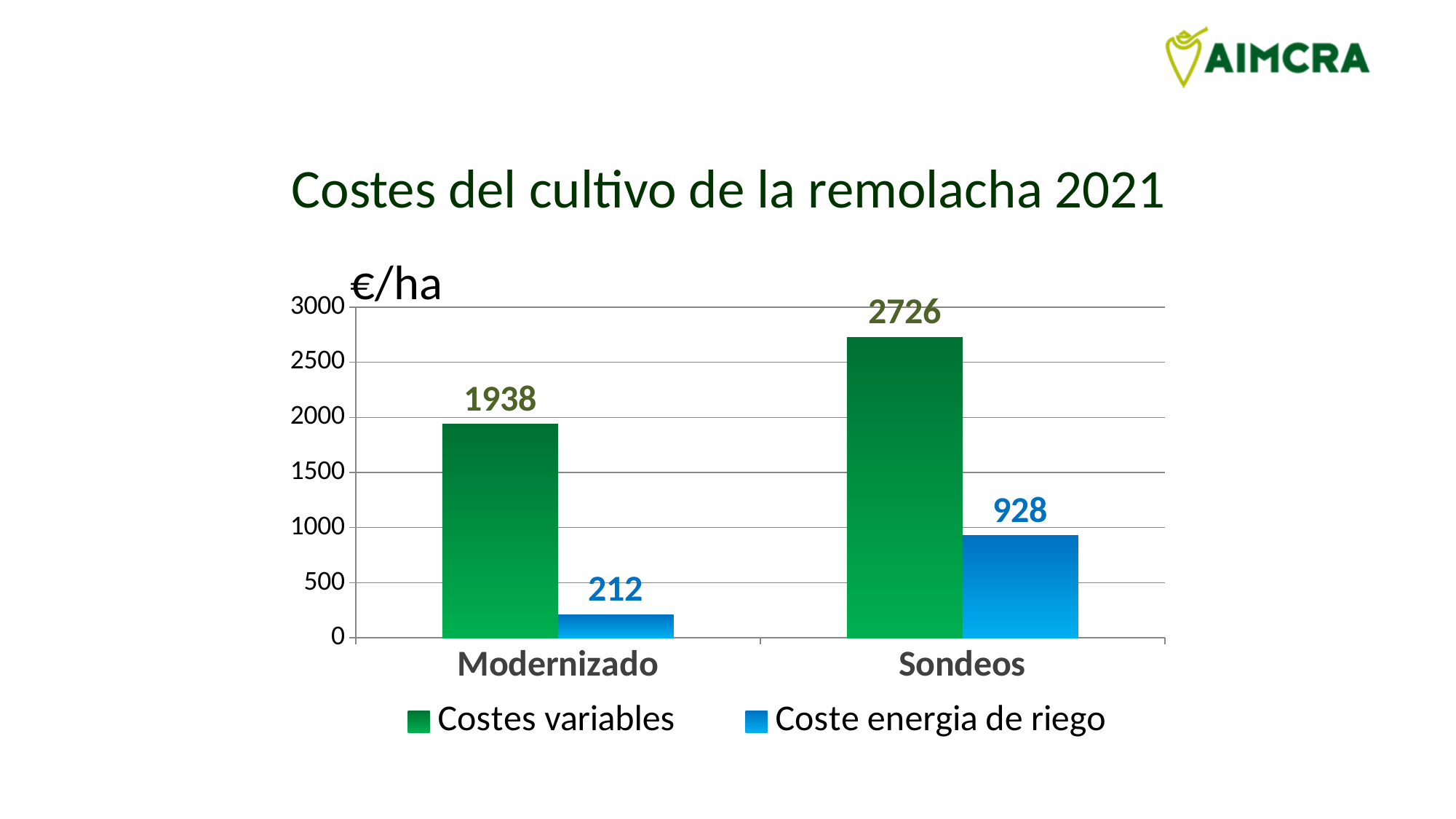
What is the value of Costes variables for Modernizado? 1938 Which is larger: Coste energia de riego for Sondeos or Coste energia de riego for Modernizado? Sondeos Which category has the lowest Coste energia de riego value? Modernizado What is the value of Coste energia de riego for Sondeos? 928 How many categories are shown on the x axis? 2 What is the difference between the Costes variables values for Sondeos and Modernizado? 788 What is the value of Coste energia de riego for Modernizado? 212 What kind of chart is shown on the slide? Bar chart How many series does the legend list? 2 What is the difference between the Coste energia de riego values for Sondeos and Modernizado? 716 Which category has the highest Costes variables value? Sondeos What is the value of Costes variables for Sondeos? 2726